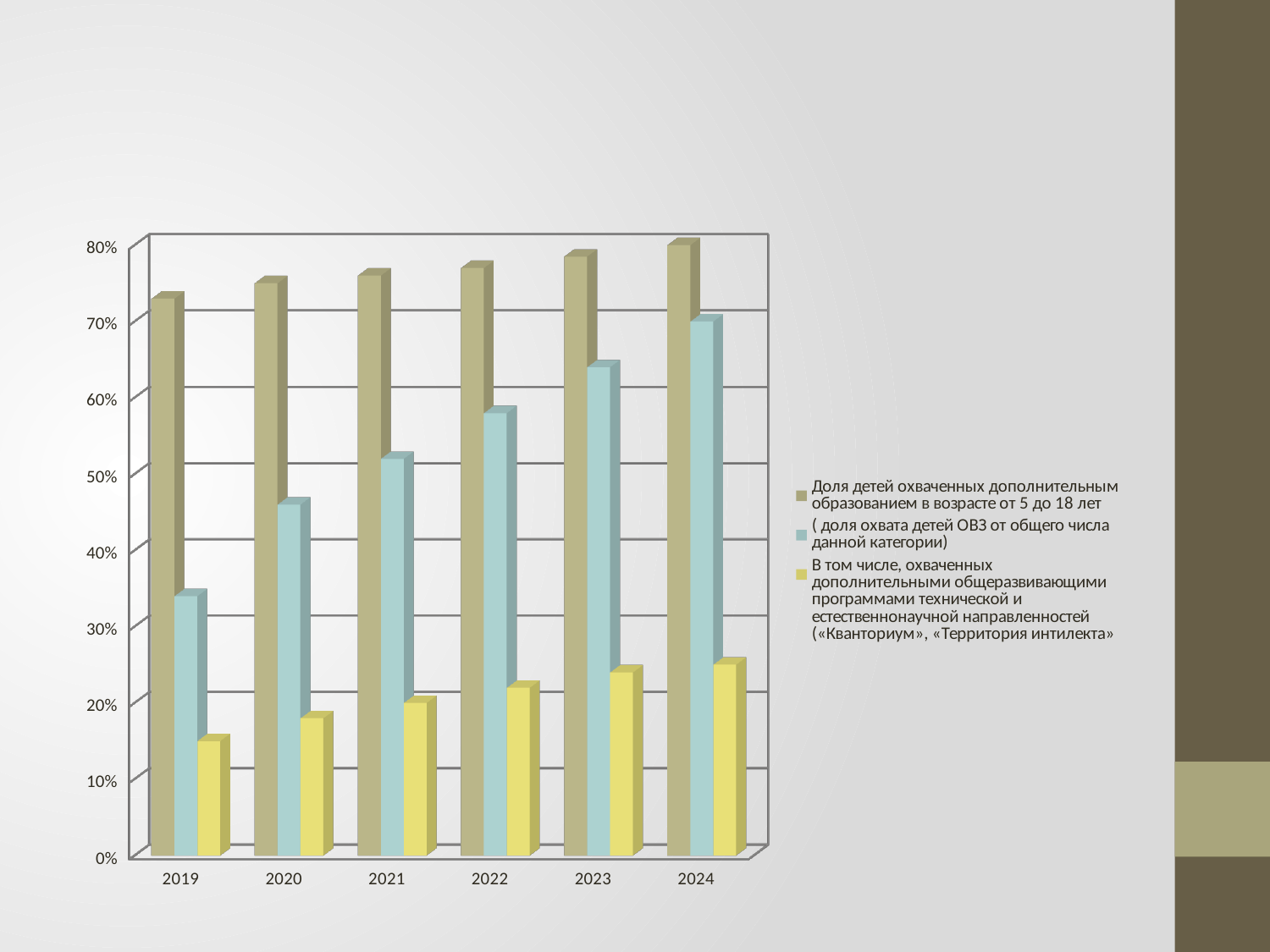
In which year is the value for '( доля охвата детей ОВЗ от общего числа данной категории)' highest? 2024 Is the 2019 value for '( доля охвата детей ОВЗ от общего числа данной категории)' greater or less than 40%? less Is the 2019 value for 'Доля детей охваченных дополнительным образованием в возрасте от 5 до 18 лет' greater or less than 60%? greater In which year is the value for the series 'В том числе, охваченных дополнительными общеразвивающими программами технической и естественнонаучной направленностей' lowest? 2019 Is the 2019 value for 'В том числе, охваченных дополнительными общеразвивающими программами технической и естественнонаучной направленностей' greater or less than 20%? less Do the values for the series '( доля охвата детей ОВЗ от общего числа данной категории)' rise or fall from 2019 to 2024? rise What is the first entry listed in the chart's legend? Доля детей охваченных дополнительным образованием в возрасте от 5 до 18 лет How many years are shown on the x axis of the chart? 6 How many series does the chart's legend list? 3 In 2019, which series has the larger value: 'Доля детей охваченных дополнительным образованием в возрасте от 5 до 18 лет' or '( доля охвата детей ОВЗ от общего числа данной категории)'? Доля детей охваченных дополнительным образованием в возрасте от 5 до 18 лет What kind of chart is shown on the slide? bar chart